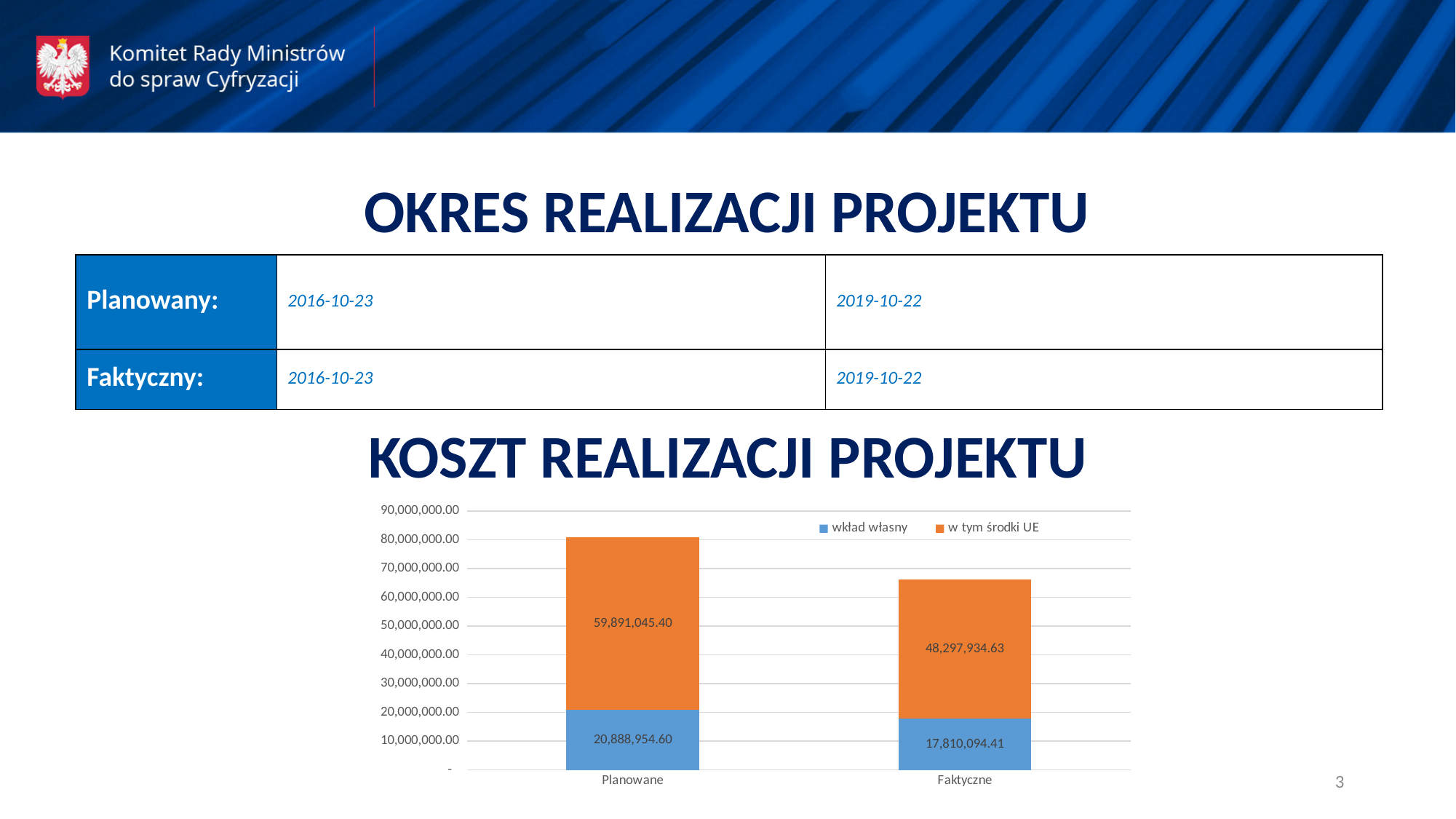
Which category has the higher value for w tym środki UE, Planowane or Faktyczne? Planowane What is the difference between wkład własny for Planowane and for Faktyczne? 3,078,860.19 What is the total of the stacked bar for Faktyczne? 66,108,029.04 What is the value of w tym środki UE for Faktyczne? 48,297,934.63 What kind of chart is shown under KOSZT REALIZACJI PROJEKTU? Stacked bar chart How many series does the legend list? 2 What is the value of w tym środki UE for Planowane? 59,891,045.40 What is the value of wkład własny for Faktyczne? 17,810,094.41 What is the total of the stacked bar for Planowane? 80,780,000.00 How many categories are shown on the x axis? 2 What is the difference between w tym środki UE for Planowane and for Faktyczne? 11,593,110.77 What is the value of wkład własny for Planowane? 20,888,954.60